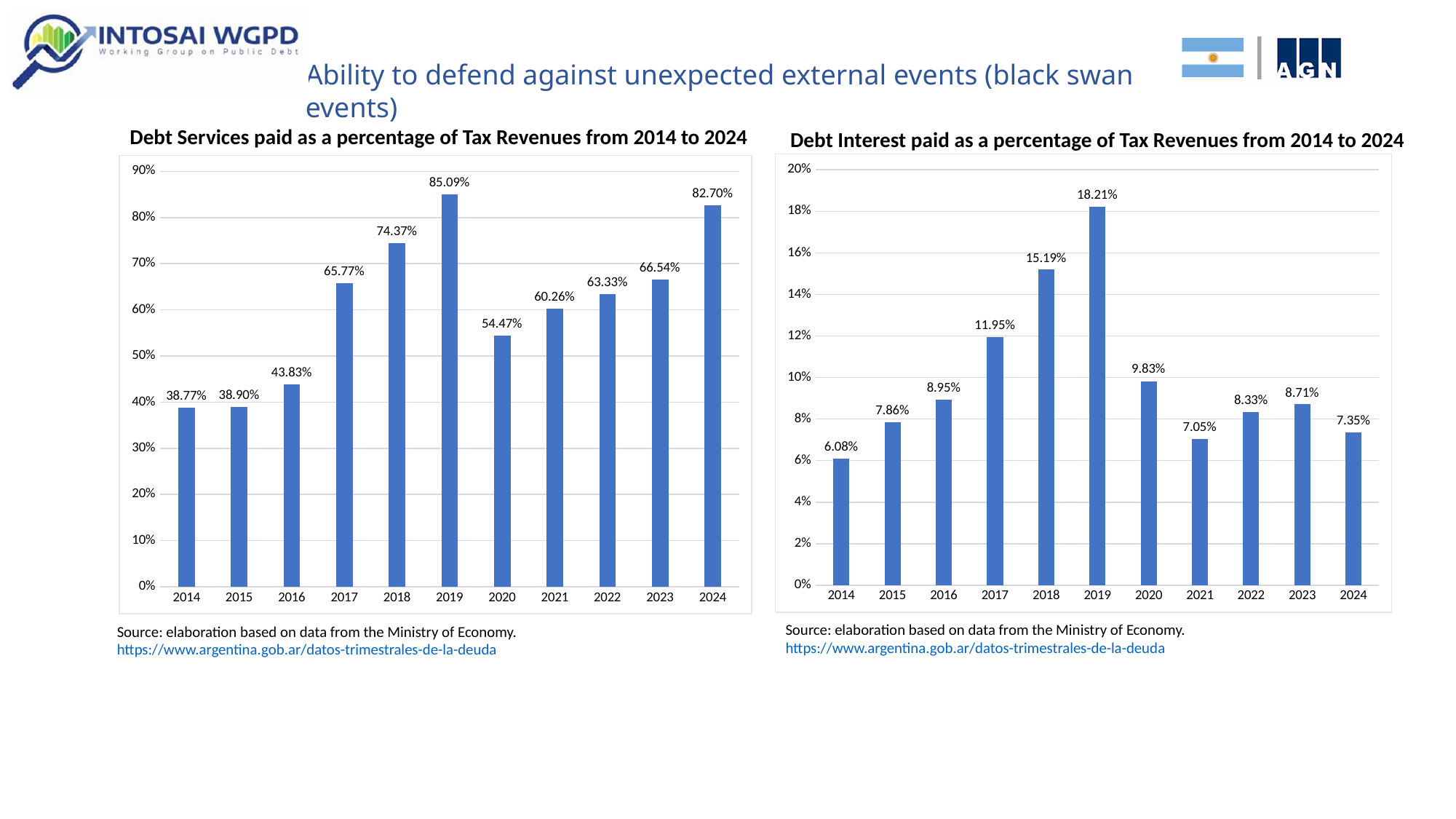
In the 'Debt Interest paid as a percentage of Tax Revenues from 2014 to 2024' chart, is the value for 2017 greater or less than 10%? greater In the 'Debt Services paid as a percentage of Tax Revenues from 2014 to 2024' chart, which is larger, the value for 2018 or the value for 2022? 2018 In the 'Debt Services paid as a percentage of Tax Revenues from 2014 to 2024' chart, which year has the highest value? 2019 What is the title of the chart on the left side of the slide? Debt Services paid as a percentage of Tax Revenues from 2014 to 2024 What kind of chart is the 'Debt Interest paid as a percentage of Tax Revenues from 2014 to 2024' chart? Bar chart In the 'Debt Interest paid as a percentage of Tax Revenues from 2014 to 2024' chart, do the values rise or fall from 2014 to 2019? Rise In the 'Debt Interest paid as a percentage of Tax Revenues from 2014 to 2024' chart, what is the difference between the values for 2019 and 2018? 3.02% In the 'Debt Services paid as a percentage of Tax Revenues from 2014 to 2024' chart, what is the difference between the values for 2024 and 2023? 16.16% How many years are shown on the x axis of the 'Debt Services paid as a percentage of Tax Revenues from 2014 to 2024' chart? 11 In the 'Debt Services paid as a percentage of Tax Revenues from 2014 to 2024' chart, what is the value for 2019? 85.09% In the 'Debt Interest paid as a percentage of Tax Revenues from 2014 to 2024' chart, what is the value for 2020? 9.83% In the 'Debt Interest paid as a percentage of Tax Revenues from 2014 to 2024' chart, which year has the lowest value? 2014